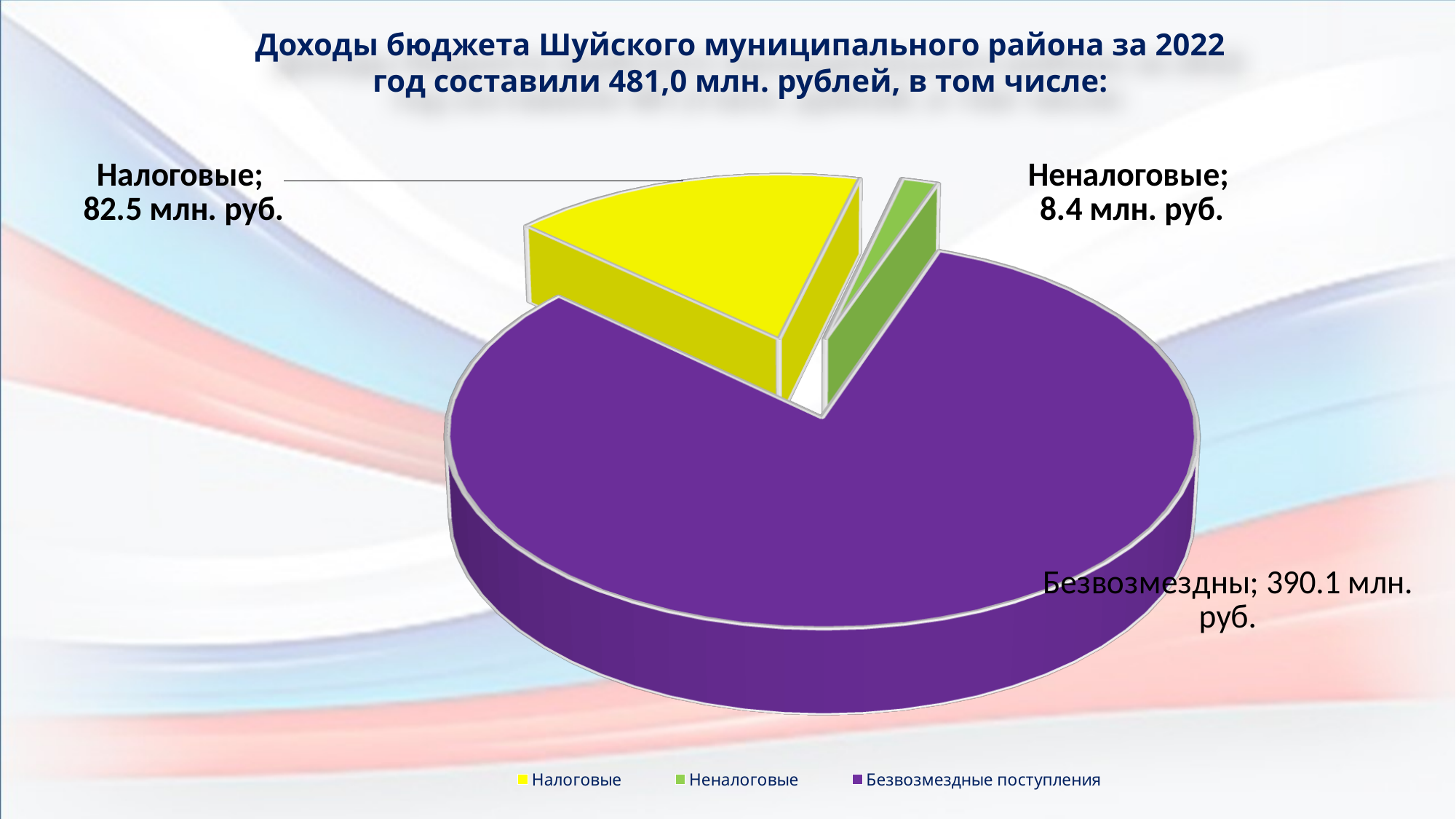
What is the value of the Налоговые slice? 82.5 млн. руб. How many entries does the legend list? 3 Which category has the smallest slice of the pie? Неналоговые What kind of chart is shown on the slide? Pie chart What is the difference between the Налоговые and Неналоговые values? 74.1 млн. руб. How many slices does the pie chart have? 3 What is the value of the Безвозмездные slice? 390.1 млн. руб. What colour is the Безвозмездные поступления slice? Purple What is the difference between the Безвозмездные and Налоговые values? 307.6 млн. руб. What is the value of the Неналоговые slice? 8.4 млн. руб. Which is larger, Налоговые or Неналоговые? Налоговые Which category has the largest slice of the pie? Безвозмездные поступления